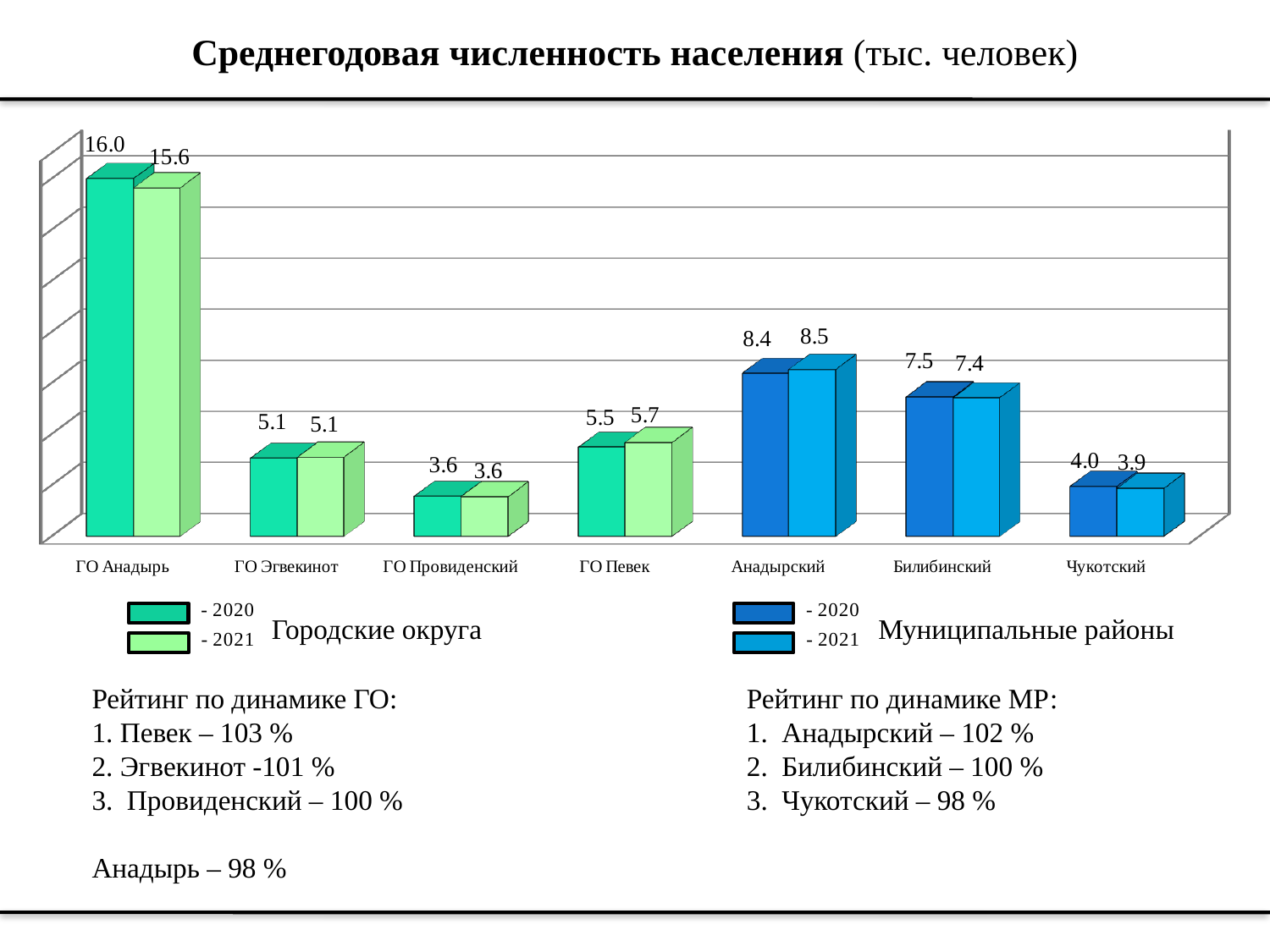
Which category has the highest 2021 value? ГО Анадырь How many categories are shown on the x axis? 7 What kind of chart is shown on the slide? Bar chart What is the 2021 value for ГО Певек? 5.7 Which category has the lowest 2020 value? ГО Провиденский What is the 2021 value for Анадырский? 8.5 Which two years does the legend list? 2020 and 2021 What is the title of the chart? Среднегодовая численность населения (тыс. человек) Which is larger: the 2021 value for Билибинский or the 2021 value for Анадырский? Анадырский What is the difference between the 2020 and 2021 values for ГО Анадырь? 0.4 What is the 2020 value for Чукотский? 4.0 What is the 2020 value for ГО Анадырь? 16.0